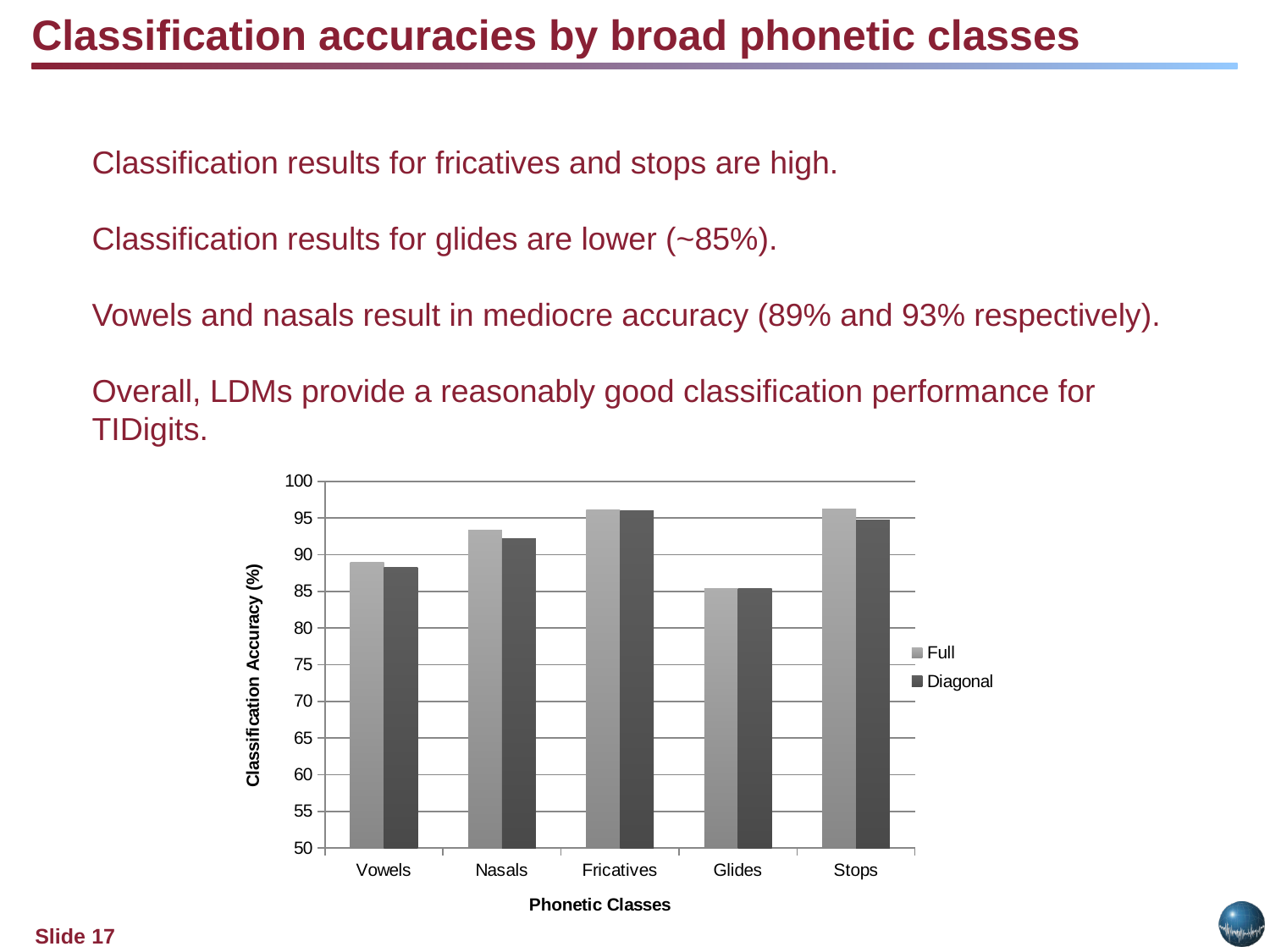
How many series does the chart's legend list? 2 What kind of chart is shown on the slide? bar chart Which phonetic class has the lowest classification accuracy for the Full series? Glides Is the Full classification accuracy for Glides greater or less than 90? less Is the Full classification accuracy for Vowels greater or less than 85? greater Which phonetic class has the lowest classification accuracy for the Diagonal series? Glides How many phonetic classes are shown on the x axis of the chart? 5 For Stops, which series has the higher classification accuracy, Full or Diagonal? Full Is the Full classification accuracy for Nasals greater or less than 90? greater For the Full series, which has the higher classification accuracy, Vowels or Nasals? Nasals What is the label of the chart's y axis? Classification Accuracy (%)